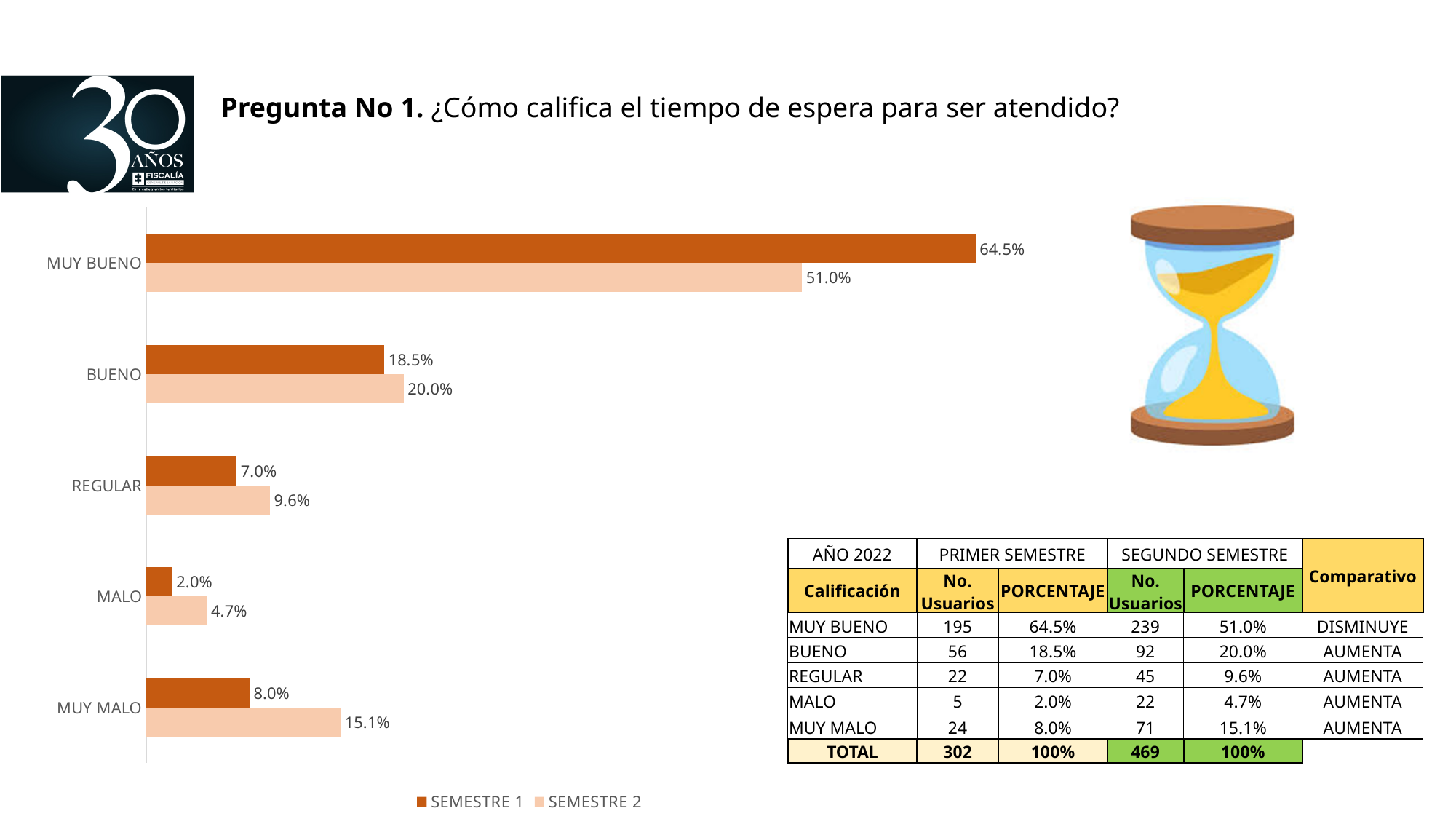
How many series does the legend list? 2 What is the SEMESTRE 2 value for REGULAR? 9.6% What are the two series named in the legend? SEMESTRE 1 and SEMESTRE 2 What is the SEMESTRE 2 value for MUY MALO? 15.1% What is the difference between the SEMESTRE 1 and SEMESTRE 2 values for MUY BUENO? 13.5% What is the SEMESTRE 1 value for MUY BUENO? 64.5% Which category has the lowest SEMESTRE 2 value? MALO Which is larger for BUENO: the SEMESTRE 1 value or the SEMESTRE 2 value? SEMESTRE 2 Which category has the highest SEMESTRE 1 value? MUY BUENO What is the difference between the SEMESTRE 2 and SEMESTRE 1 values for MUY MALO? 7.1% What kind of chart is shown on the slide? Bar chart How many categories are shown on the chart? 5